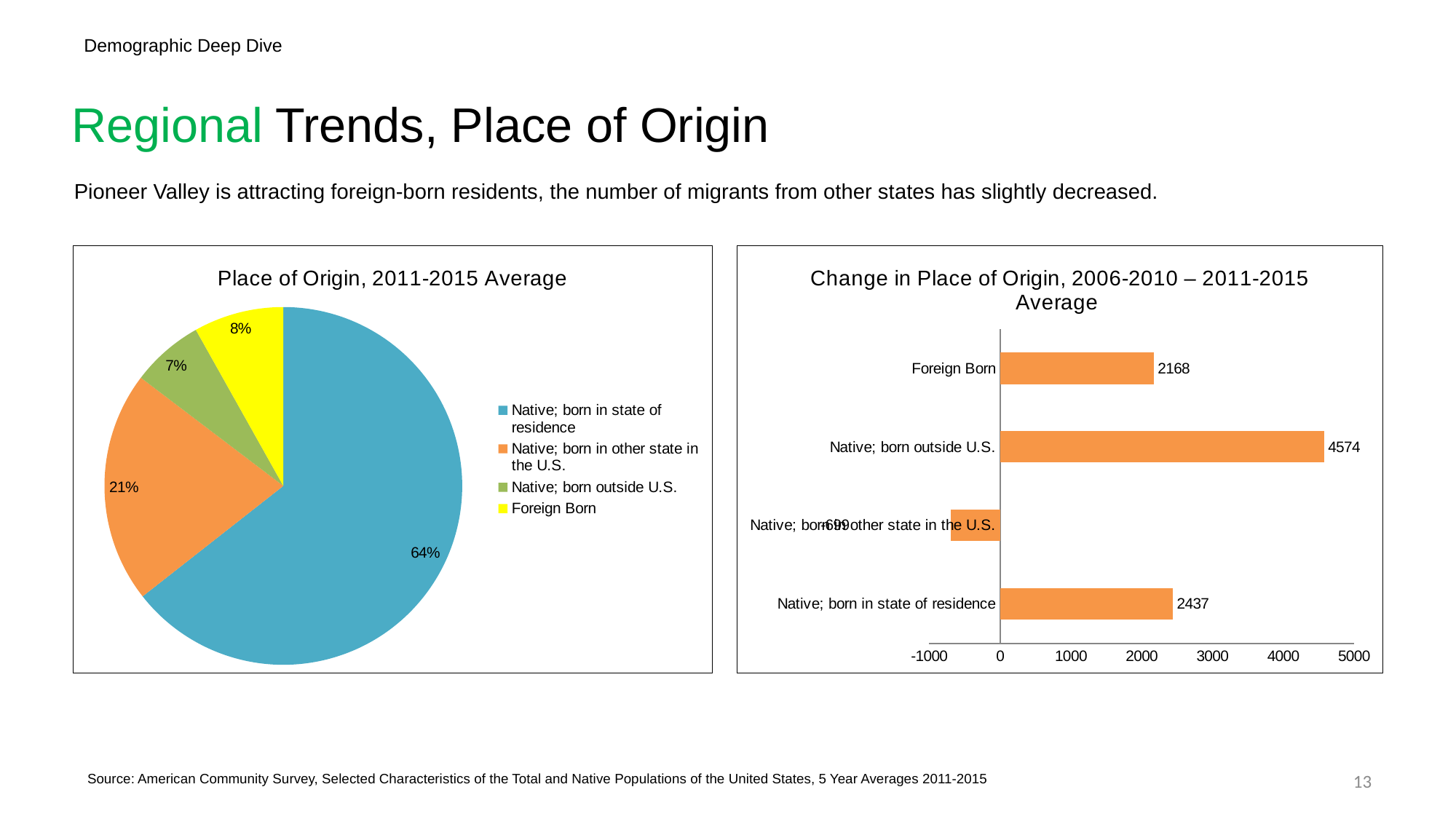
In the pie chart 'Place of Origin, 2011-2015 Average', how many slices are there? 4 In the pie chart 'Place of Origin, 2011-2015 Average', what share is 'Native; born in state of residence'? 64% In the chart 'Change in Place of Origin, 2006-2010 – 2011-2015 Average', what is the value for 'Foreign Born'? 2168 In the pie chart 'Place of Origin, 2011-2015 Average', what share is 'Native; born in other state in the U.S.'? 21% In the pie chart 'Place of Origin, 2011-2015 Average', which category has the smallest slice? Native; born outside U.S. In the chart 'Change in Place of Origin, 2006-2010 – 2011-2015 Average', what is the value for 'Native; born outside U.S.'? 4574 In the pie chart 'Place of Origin, 2011-2015 Average', what share is 'Foreign Born'? 8% In the pie chart 'Place of Origin, 2011-2015 Average', what colour is the 'Foreign Born' slice? Yellow What kind of chart is 'Change in Place of Origin, 2006-2010 – 2011-2015 Average'? Bar chart In the chart 'Change in Place of Origin, 2006-2010 – 2011-2015 Average', which category has the highest value? Native; born outside U.S. In the chart 'Change in Place of Origin, 2006-2010 – 2011-2015 Average', what is the difference between 'Native; born in state of residence' and 'Foreign Born'? 269 In the chart 'Change in Place of Origin, 2006-2010 – 2011-2015 Average', is the value for 'Native; born in other state in the U.S.' greater or less than 0? less